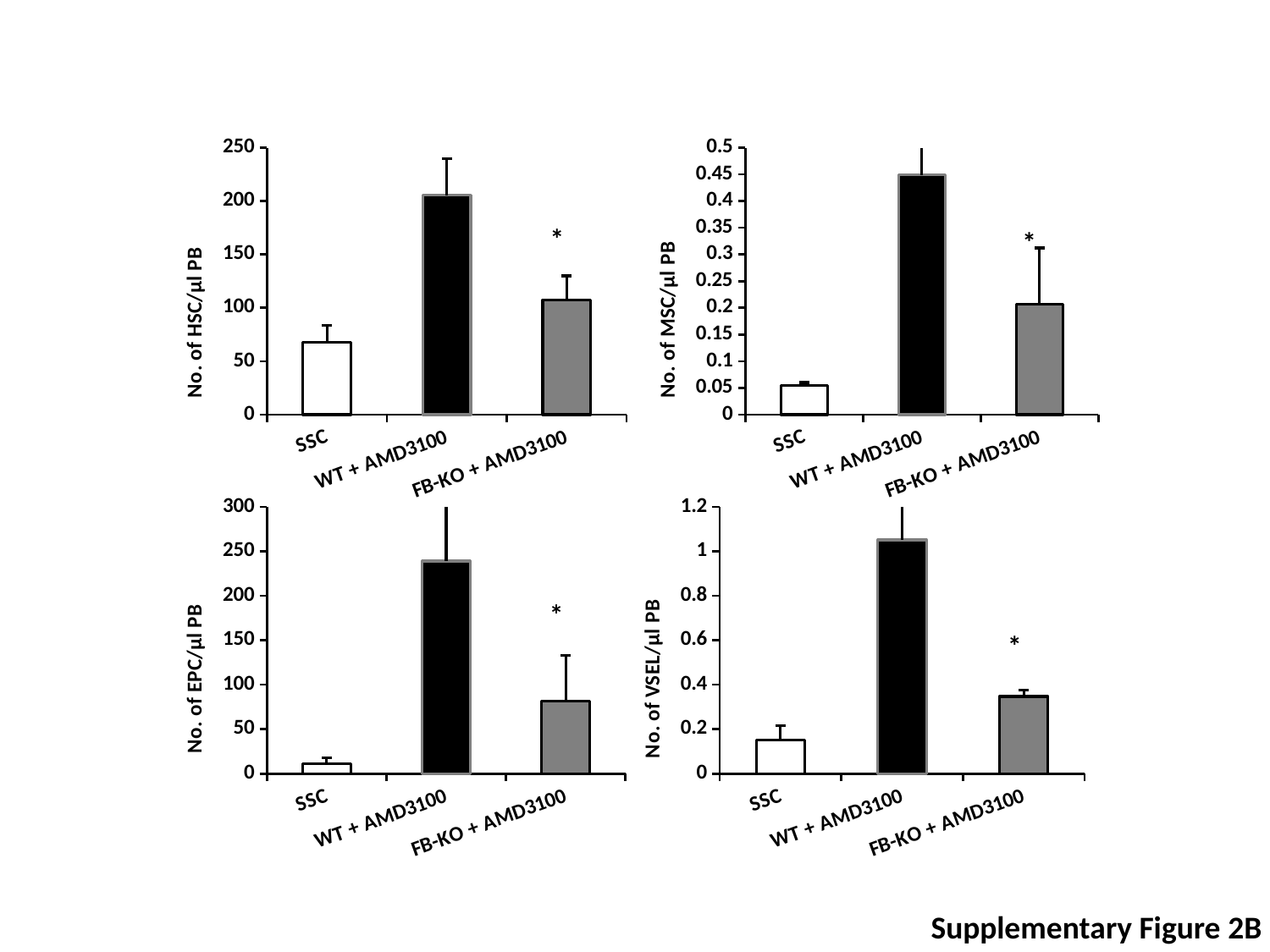
In the bottom-left chart (No. of EPC/µl PB), which category has the lowest value? SSC What kind of chart is the top-left chart (No. of HSC/µl PB)? bar chart In the top-right chart (No. of MSC/µl PB), which is larger, the value for WT + AMD3100 or FB-KO + AMD3100? WT + AMD3100 In the top-left chart (No. of HSC/µl PB), which category has the highest value? WT + AMD3100 In the top-left chart (No. of HSC/µl PB), is the value for WT + AMD3100 greater or less than 150? greater In the bottom-right chart (No. of VSEL/µl PB), which category has the highest value? WT + AMD3100 In the top-right chart (No. of MSC/µl PB), is the value for SSC greater or less than 0.1? less In the bottom-left chart (No. of EPC/µl PB), is the value for WT + AMD3100 greater or less than 200? greater In the top-left chart (No. of HSC/µl PB), which category has the lowest value? SSC How many categories are shown on the x axis of the bottom-left chart (No. of EPC/µl PB)? 3